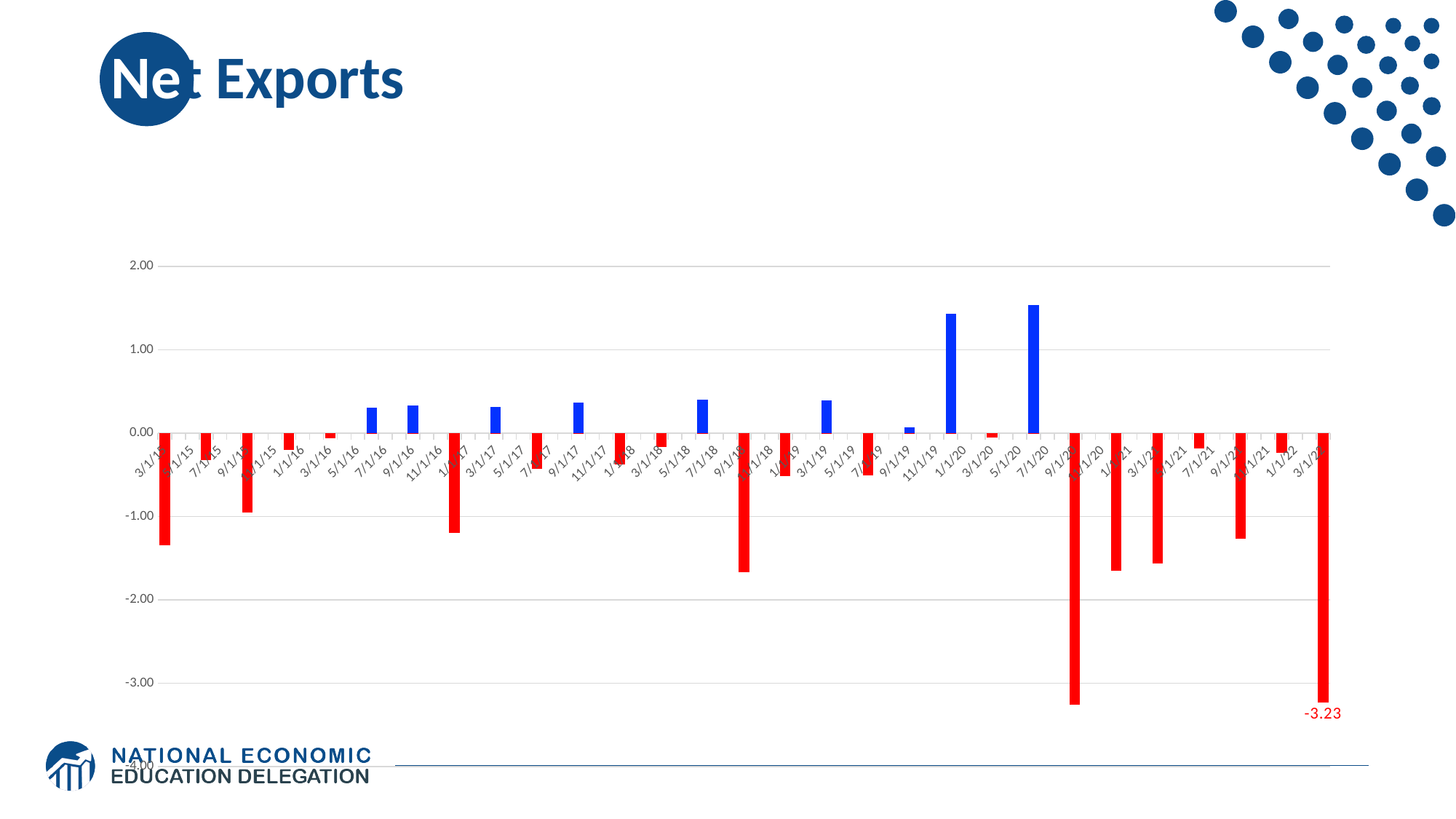
What colour are the bars with negative values? red What kind of chart is shown on the slide? bar chart Which is larger, the value for 3/1/21 or the value for 3/1/22? 3/1/21 Is the value for 1/1/20 greater or less than 1.00? greater Is the value for 9/1/18 greater or less than -1.00? less Is the value for 9/1/21 greater or less than -1.00? less Which date has the highest value? 7/1/20 Which is larger, the value for 7/1/20 or the value for 7/1/18? 7/1/20 What is the value for 3/1/22? -3.23